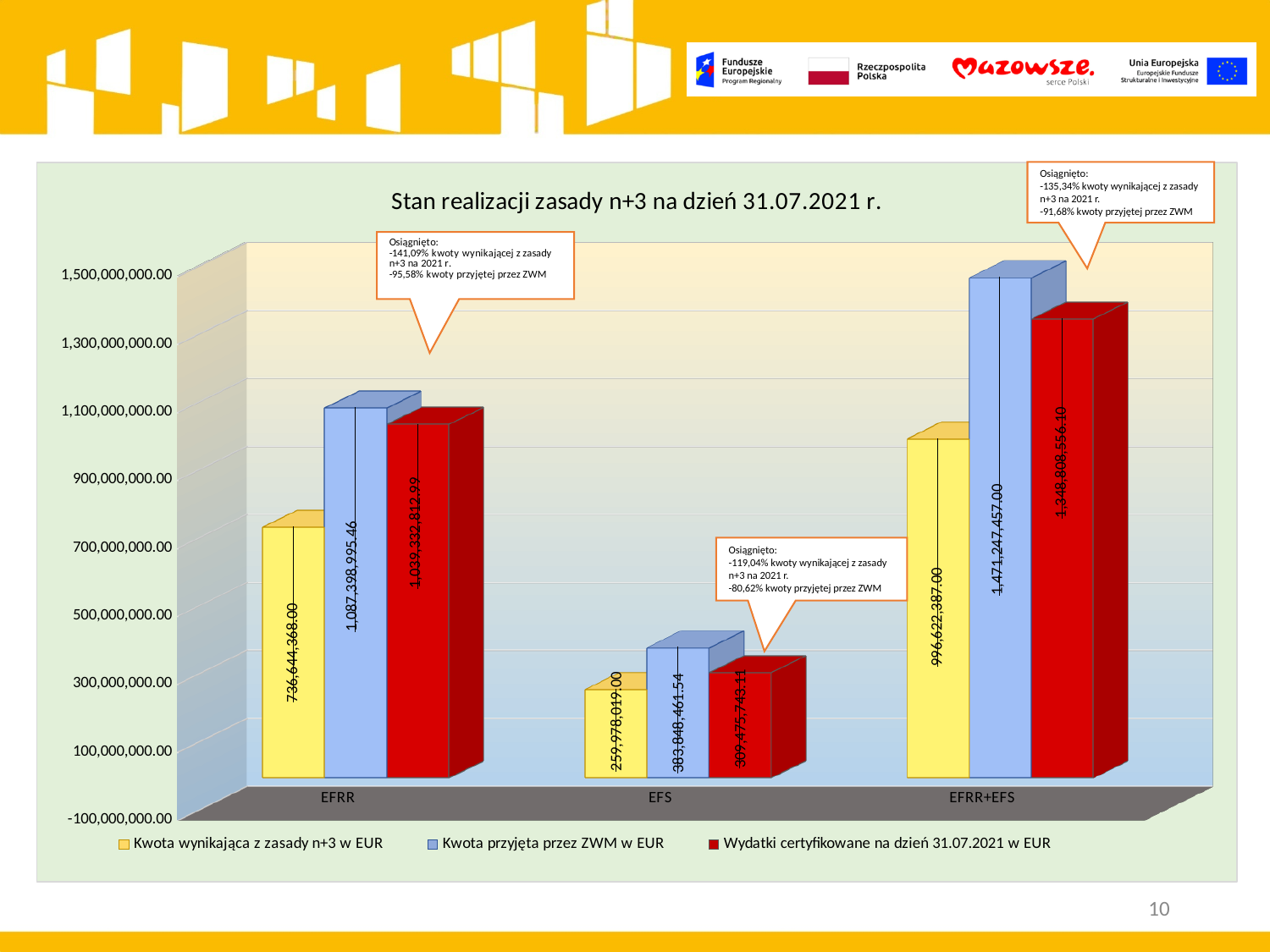
What is the value of 'Wydatki certyfikowane na dzień 31.07.2021 w EUR' for EFS? 309,475,743.11 What is the title of the chart? Stan realizacji zasady n+3 na dzień 31.07.2021 r. What kind of chart is shown on the slide? bar chart What is the value of 'Kwota przyjęta przez ZWM w EUR' for EFRR? 1,087,398,995.46 Which category has the highest value for 'Kwota przyjęta przez ZWM w EUR'? EFRR+EFS How many categories are shown on the x axis? 3 What is the difference between 'Kwota przyjęta przez ZWM w EUR' and 'Wydatki certyfikowane na dzień 31.07.2021 w EUR' for EFRR? 48,066,182.47 For EFS, which is larger: 'Kwota przyjęta przez ZWM w EUR' or 'Wydatki certyfikowane na dzień 31.07.2021 w EUR'? Kwota przyjęta przez ZWM w EUR Is the value of 'Kwota wynikająca z zasady n+3 w EUR' for EFRR greater or less than 700,000,000.00? greater Which category has the lowest value for 'Wydatki certyfikowane na dzień 31.07.2021 w EUR'? EFS What is the value of 'Kwota wynikająca z zasady n+3 w EUR' for EFRR+EFS? 996,622,387.00 How many series does the legend list? 3